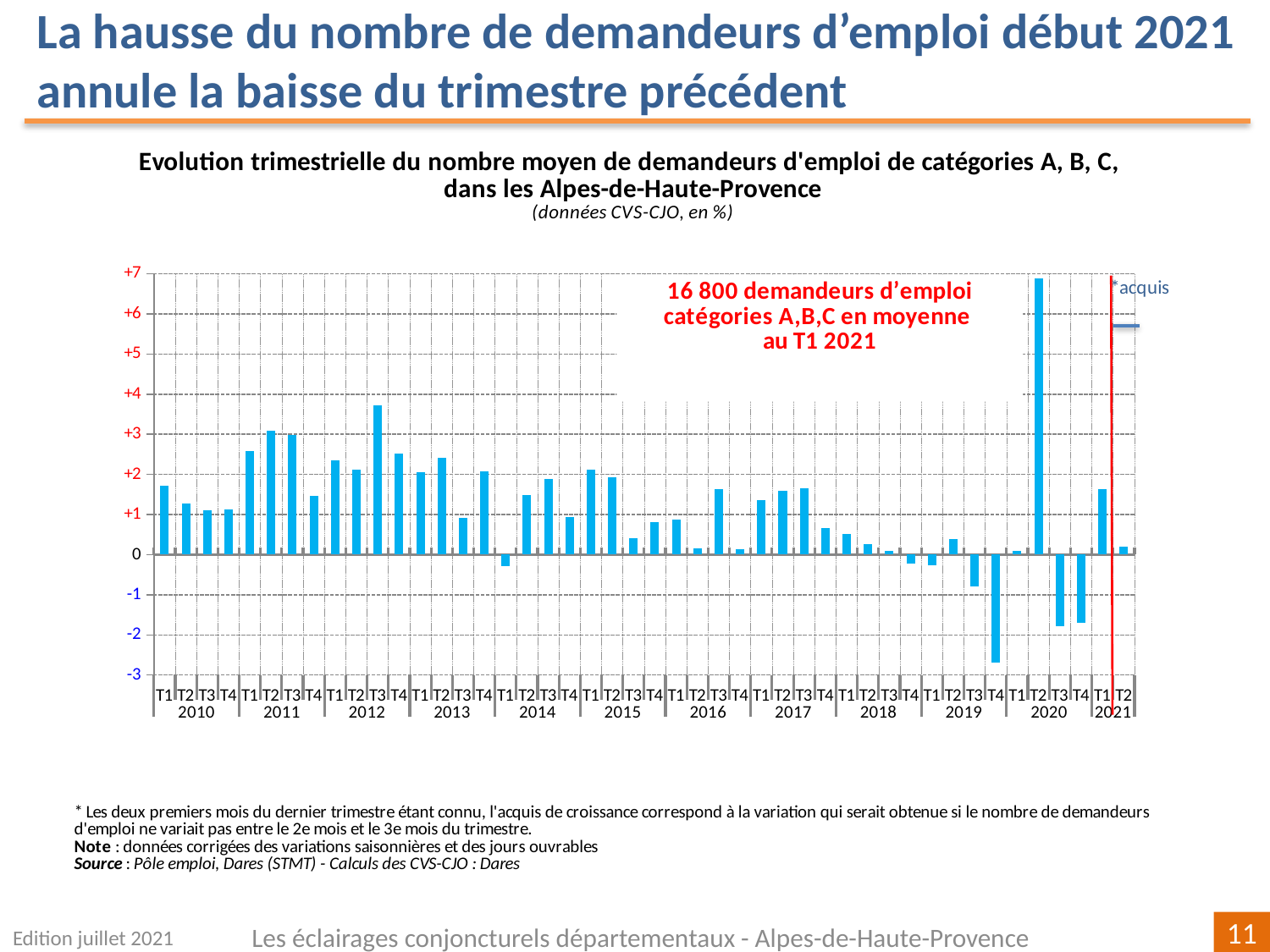
How many quarterly bars are plotted in the chart? 46 Which quarter has the lowest value in the chart? T4 2019 Which is lower, the value for T4 2019 or the value for T3 2020? T4 2019 Is the value for T4 2019 greater or less than -2? less According to the annotation on the chart, how many demandeurs d'emploi of categories A, B, C were there on average in T1 2021? 16 800 Is the value for T2 2020 greater or less than +6? greater Which is larger, the value for T1 2021 or the value for T2 2021? T1 2021 Is the value for T3 2012 greater or less than +3? greater Which quarter has the highest value in the chart? T2 2020 What kind of chart is shown on the slide? Bar chart